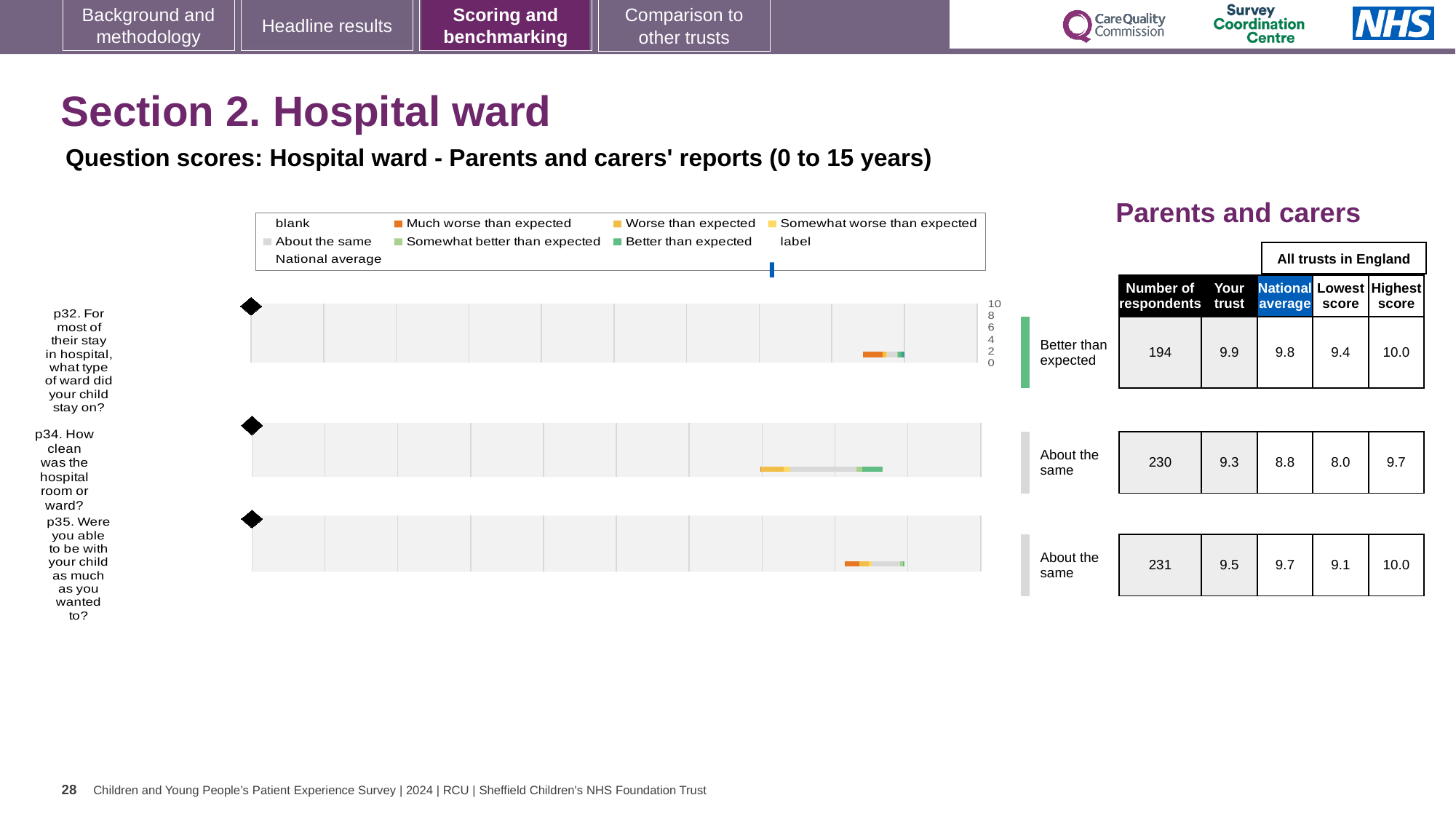
What kind of chart is used to show the question scores on this slide? bar chart Which question has the highest 'Your trust' score? p32. For most of their stay in hospital, what type of ward did your child stay on? For p35, which is larger: the 'Your trust' score or the national average? National average What is the difference between the 'Your trust' score and the national average for p34? 0.5 What colour does the legend use for 'Better than expected'? green What is the 'Your trust' score for p34 (how clean was the hospital room or ward)? 9.3 How many questions (categories) are plotted in the chart? 3 What is the highest score across all trusts in England for p34 (how clean was the hospital room or ward)? 9.7 Which benchmark label is shown next to the bar for p34 (how clean was the hospital room or ward)? About the same What is the national average score for p35 (were you able to be with your child as much as you wanted to)? 9.7 Which benchmark label is shown next to the bar for p32 (what type of ward did your child stay on)? Better than expected What is the number of respondents for p32 (what type of ward did your child stay on)? 194